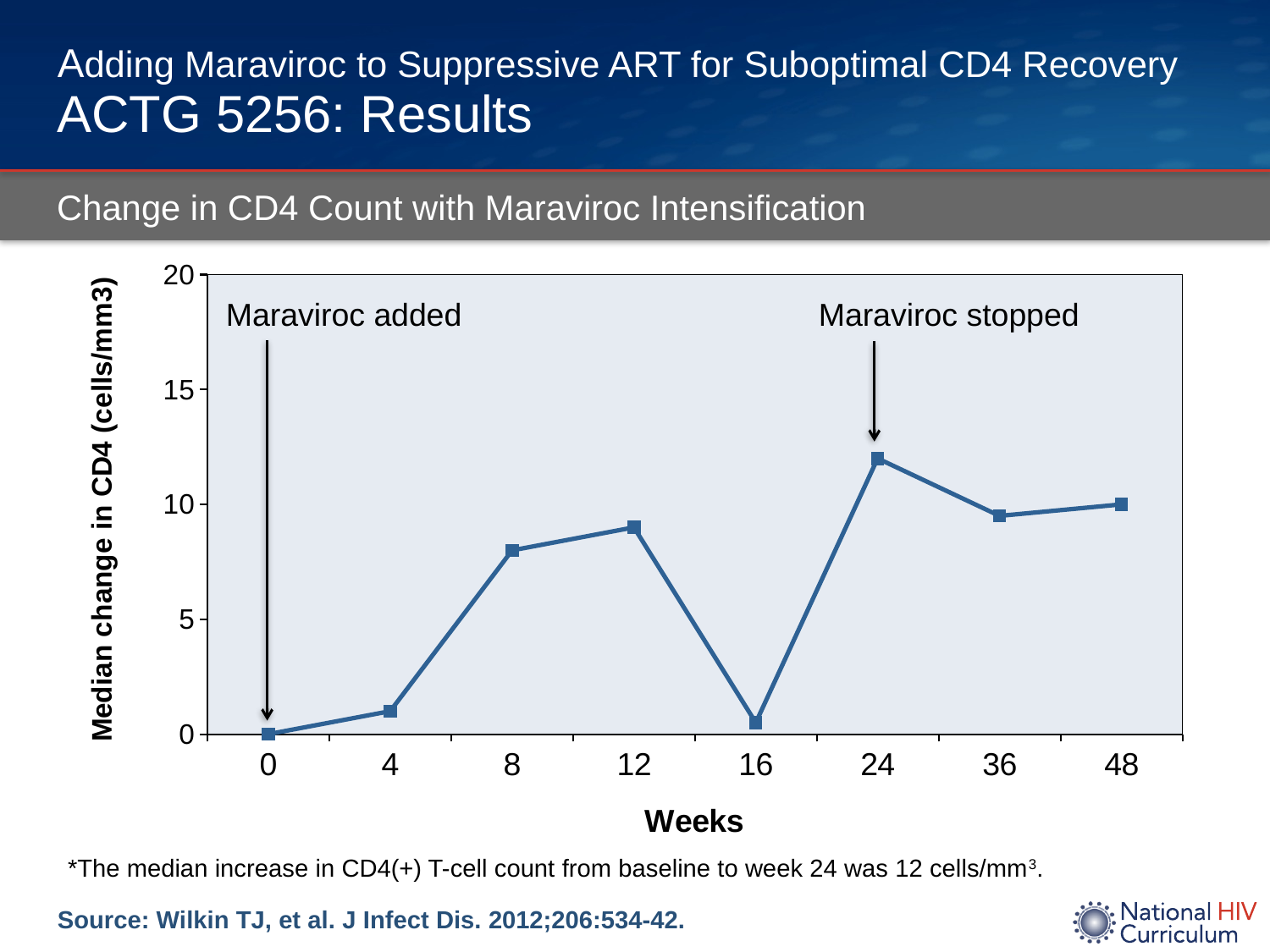
How many data points are plotted on the line? 8 Is the value at week 16 greater or less than 5? less Which has the larger median change in CD4 count, week 8 or week 16? week 8 Does the median change in CD4 count rise or fall between week 12 and week 16? fall Is the value at week 12 greater or less than 10? less What is the median change in CD4 count at week 0? 0 What kind of chart is shown on the slide? line chart Is the value at week 8 greater or less than 5? greater At which week is the median change in CD4 count highest? 24 At which week does the annotation 'Maraviroc stopped' point? 24 What is the median change in CD4 count at week 24? 12 cells/mm3 What is the label on the x axis? Weeks